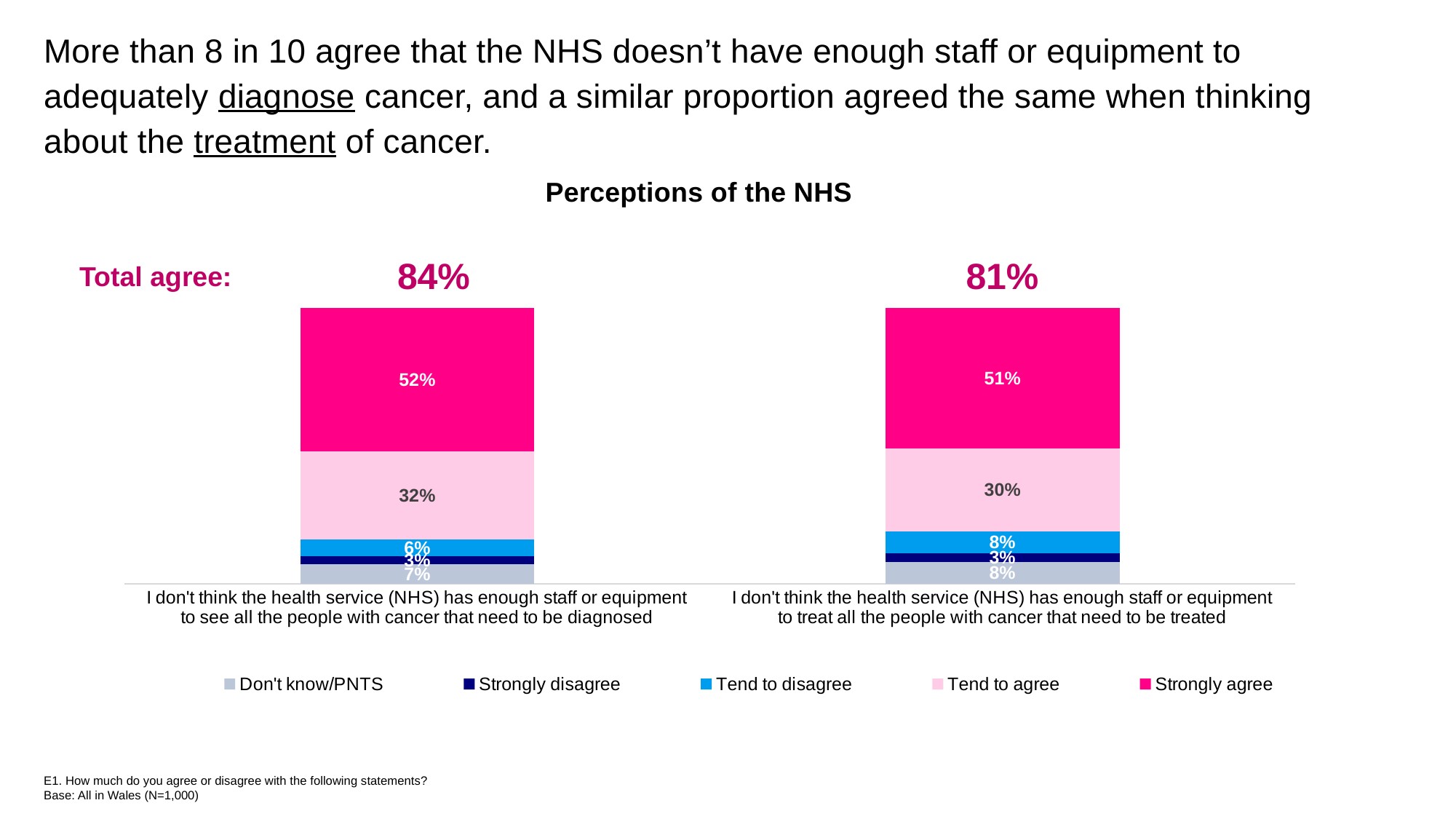
What is the difference between the Total agree figures for the diagnosis statement and the treatment statement? 3% What is the Tend to disagree value for the statement about seeing all the people with cancer that need to be diagnosed? 6% How many statements (categories) are plotted on the chart? 2 Which legend entry is shown in the darkest blue colour? Strongly disagree What is the Don't know/PNTS value for the statement about treating all the people with cancer that need to be treated? 8% What type of chart is shown under the title "Perceptions of the NHS"? Stacked bar chart Which series is the smallest segment in the bar for the statement about treating cancer? Strongly disagree How many series does the legend list? 5 What percentage strongly agree that the NHS doesn't have enough staff or equipment to see all the people with cancer that need to be diagnosed? 52% What is the Total agree figure shown for the statement about diagnosing cancer? 84% What percentage tend to agree that the NHS doesn't have enough staff or equipment to treat all the people with cancer that need to be treated? 30% Which statement has the higher Strongly agree value: the one about diagnosing cancer or the one about treating cancer? The one about diagnosing cancer